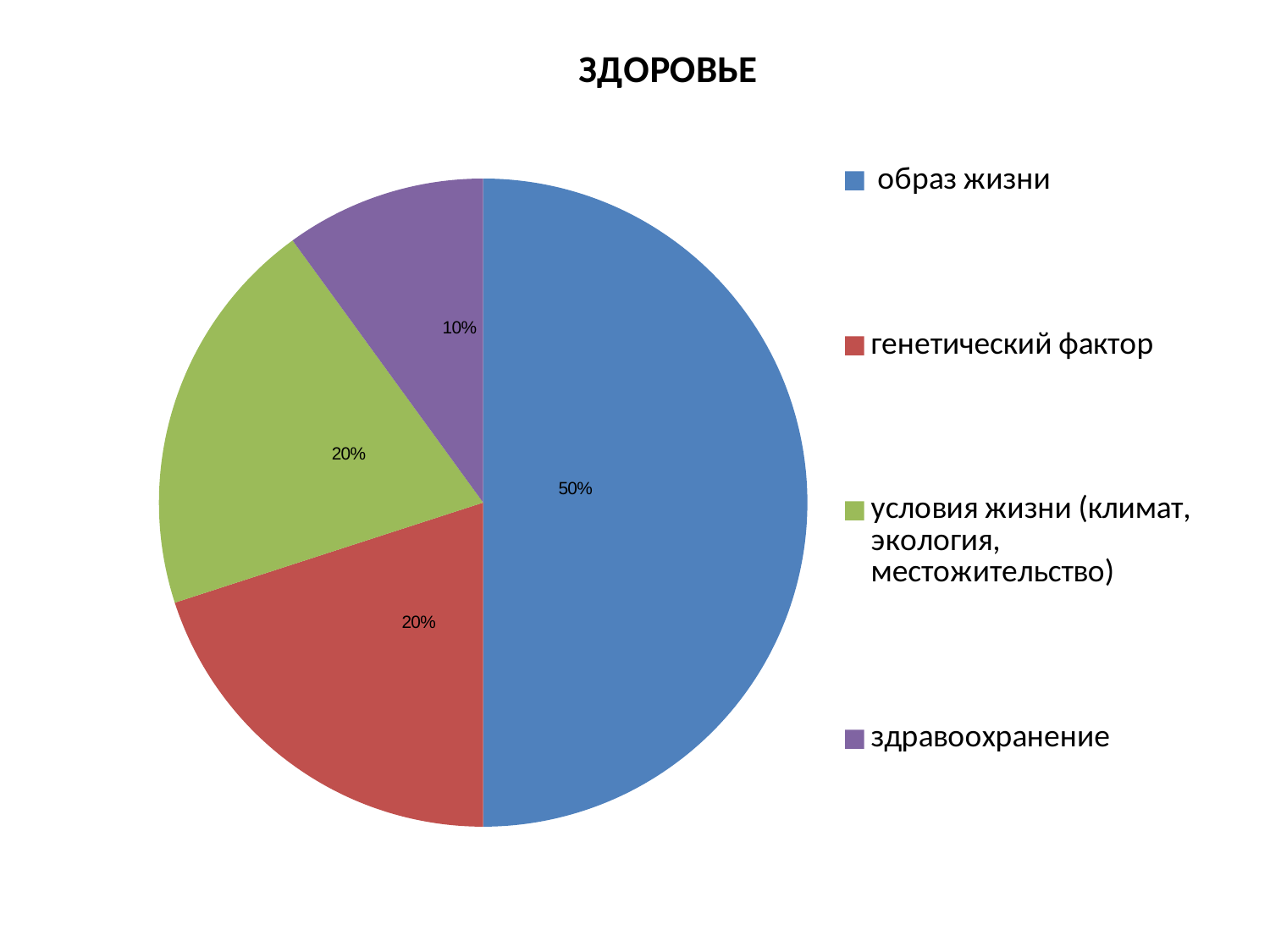
What kind of chart is shown on the slide? pie chart Which category has the largest slice of the pie? образ жизни What colour is the slice for здравоохранение? purple Which category has the smallest slice of the pie? здравоохранение What is the difference between the share for образ жизни and the share for здравоохранение? 40% Which is larger, the share for образ жизни or the share for генетический фактор? образ жизни What is the value shown for условия жизни (климат, экология, местожительство)? 20% What share of the pie does образ жизни take? 50% How many slices does the pie chart have? 4 What is the value shown for генетический фактор? 20% What is the title of the chart? ЗДОРОВЬЕ What is the value shown for здравоохранение? 10%